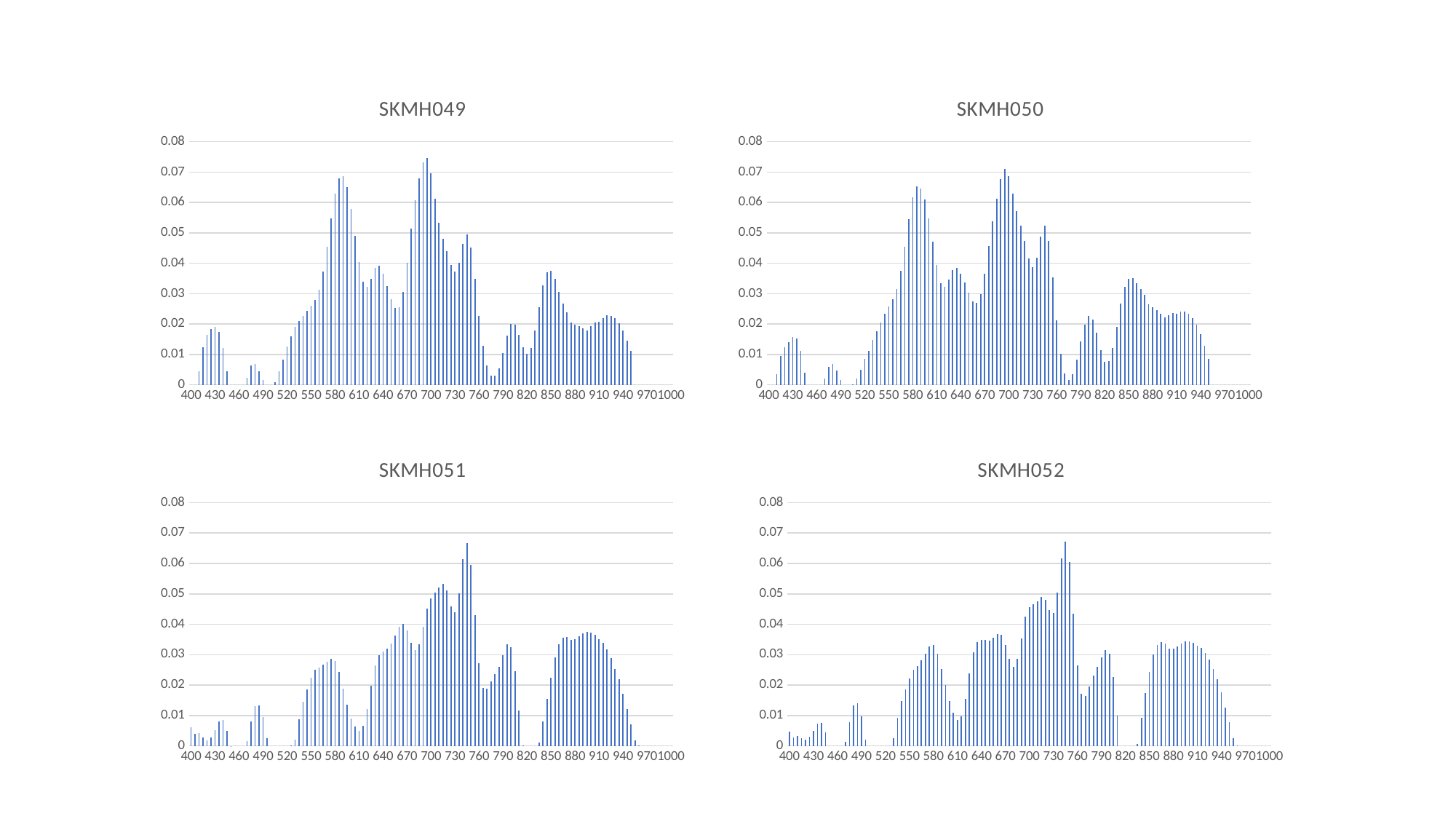
In the SKMH051 chart, is the tallest bar (near 745) greater or less than 0.06? greater What is the title of the top-left chart? SKMH049 In the SKMH052 chart, is the tallest bar (near 745) greater or less than 0.06? greater How many charts are shown on the slide? 4 Which chart has the higher tallest bar, SKMH049 or SKMH051? SKMH049 In the SKMH050 chart, is the tallest bar in the cluster near 580 greater or less than 0.06? greater What kind of chart is SKMH049? bar chart What is the title of the bottom-right chart? SKMH052